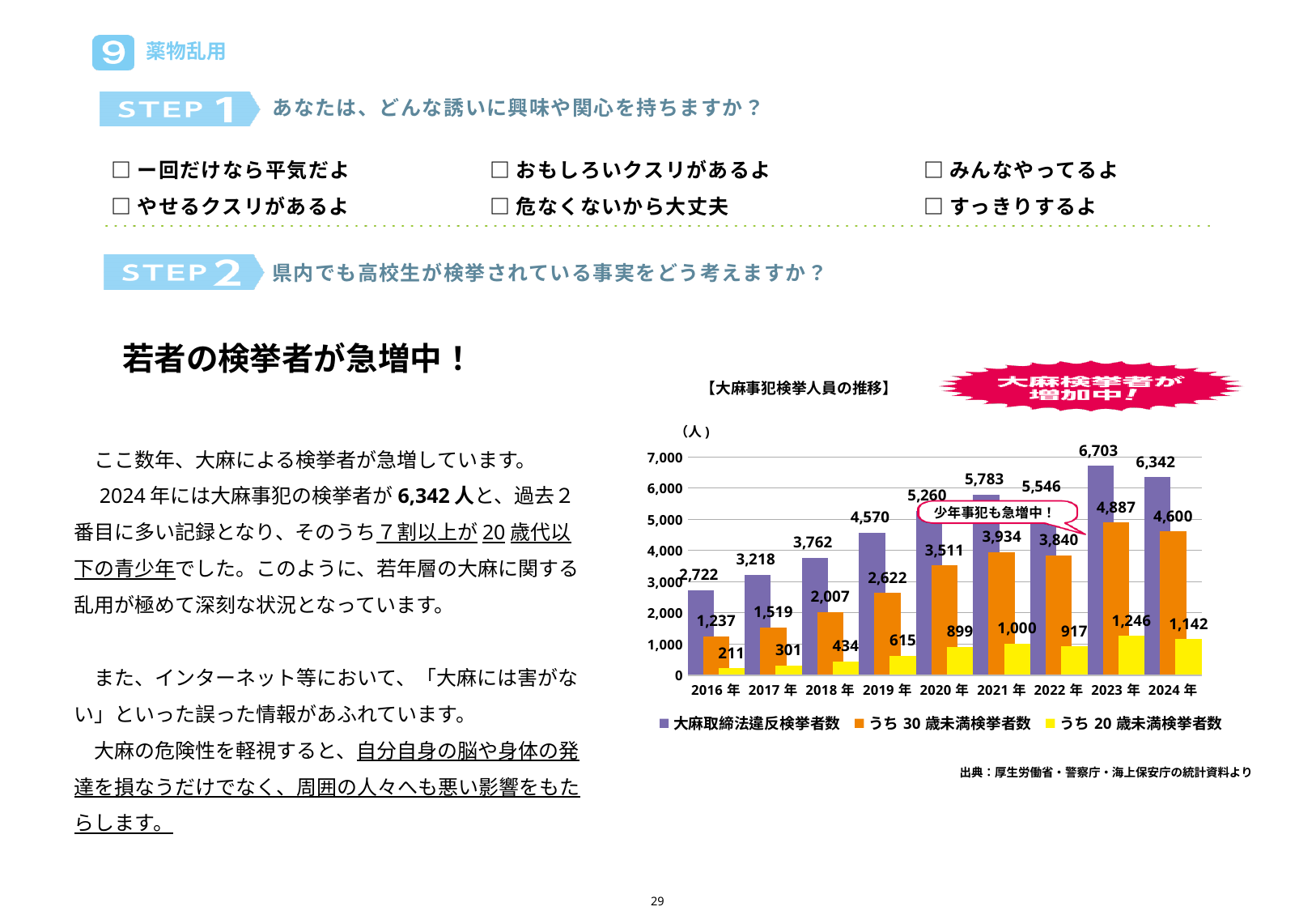
【大麻事犯検挙人員の推移】のグラフで、2016年から2021年にかけて大麻取締法違反検挙者数は増加していますか、減少していますか？ 増加 【大麻事犯検挙人員の推移】のグラフで、2021年のうち20歳未満検挙者数はいくつですか？ 1,000 【大麻事犯検挙人員の推移】のグラフで、2023年と2024年の大麻取締法違反検挙者数の差はいくつですか？ 361 【大麻事犯検挙人員の推移】のグラフで、大麻取締法違反検挙者数が最も多い年はどれですか？ 2023年 【大麻事犯検挙人員の推移】のグラフで、うち20歳未満検挙者数が最も少ない年はどれですか？ 2016年 【大麻事犯検挙人員の推移】はどの種類のグラフですか？ 棒グラフ 【大麻事犯検挙人員の推移】のグラフで、2024年の大麻取締法違反検挙者数はいくつですか？ 6,342 【大麻事犯検挙人員の推移】のグラフで、2021年と2022年では、うち30歳未満検挙者数はどちらが多いですか？ 2021年 【大麻事犯検挙人員の推移】のグラフで、2019年のうち30歳未満検挙者数はいくつですか？ 2,622 【大麻事犯検挙人員の推移】のグラフの凡例には、いくつの系列がありますか？ 3 【大麻事犯検挙人員の推移】のグラフには、何年分のデータが示されていますか？ 9 【大麻事犯検挙人員の推移】のグラフで、2020年の大麻取締法違反検挙者数は5,000より多いですか、少ないですか？ 多い